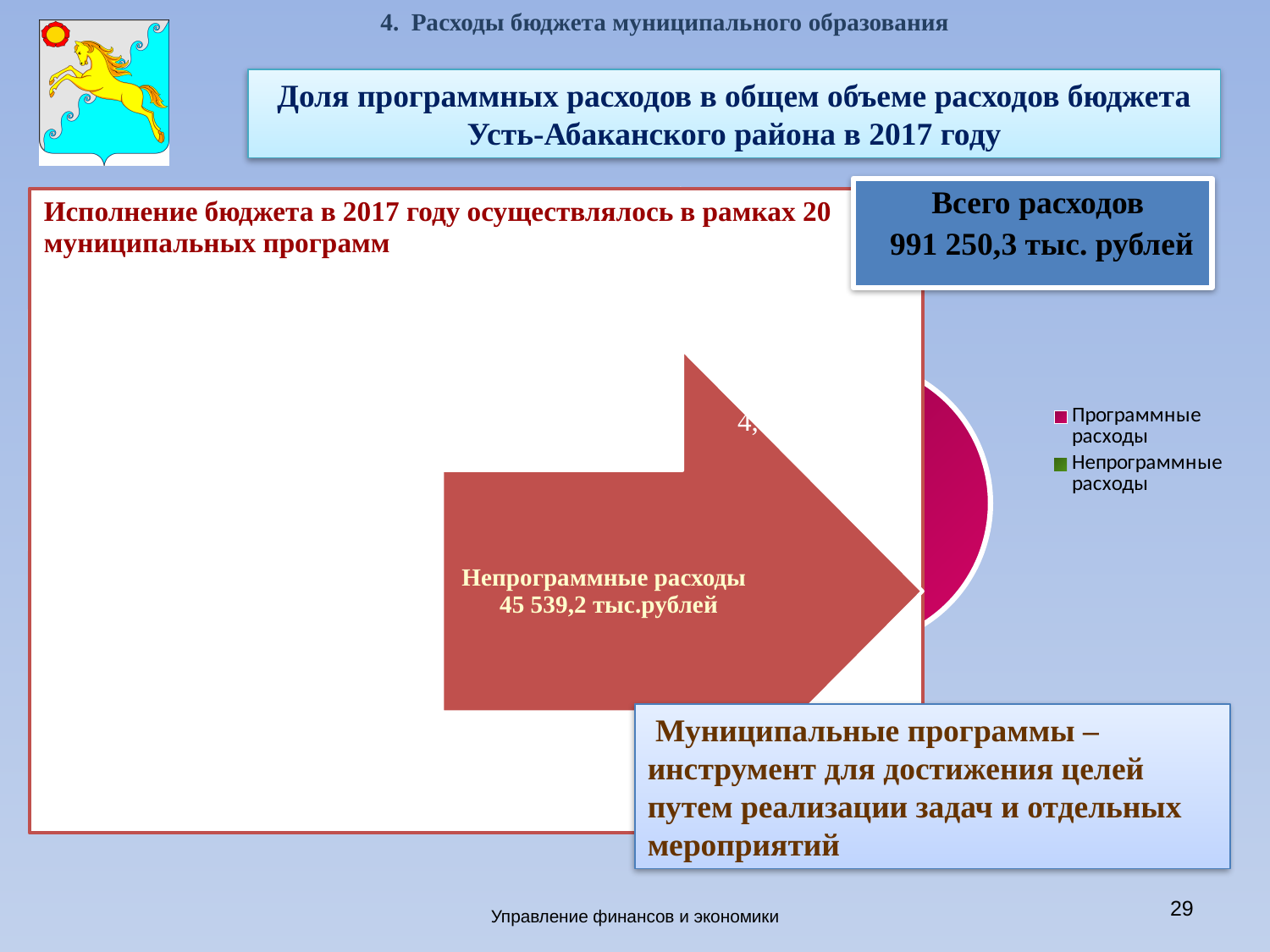
Which category has the larger share of the pie, Программные расходы or Непрограммные расходы? Программные расходы How many entries does the chart legend list? 2 What kind of chart is shown on the slide? pie chart What is the first entry in the chart legend? Программные расходы What is the second entry in the chart legend? Непрограммные расходы